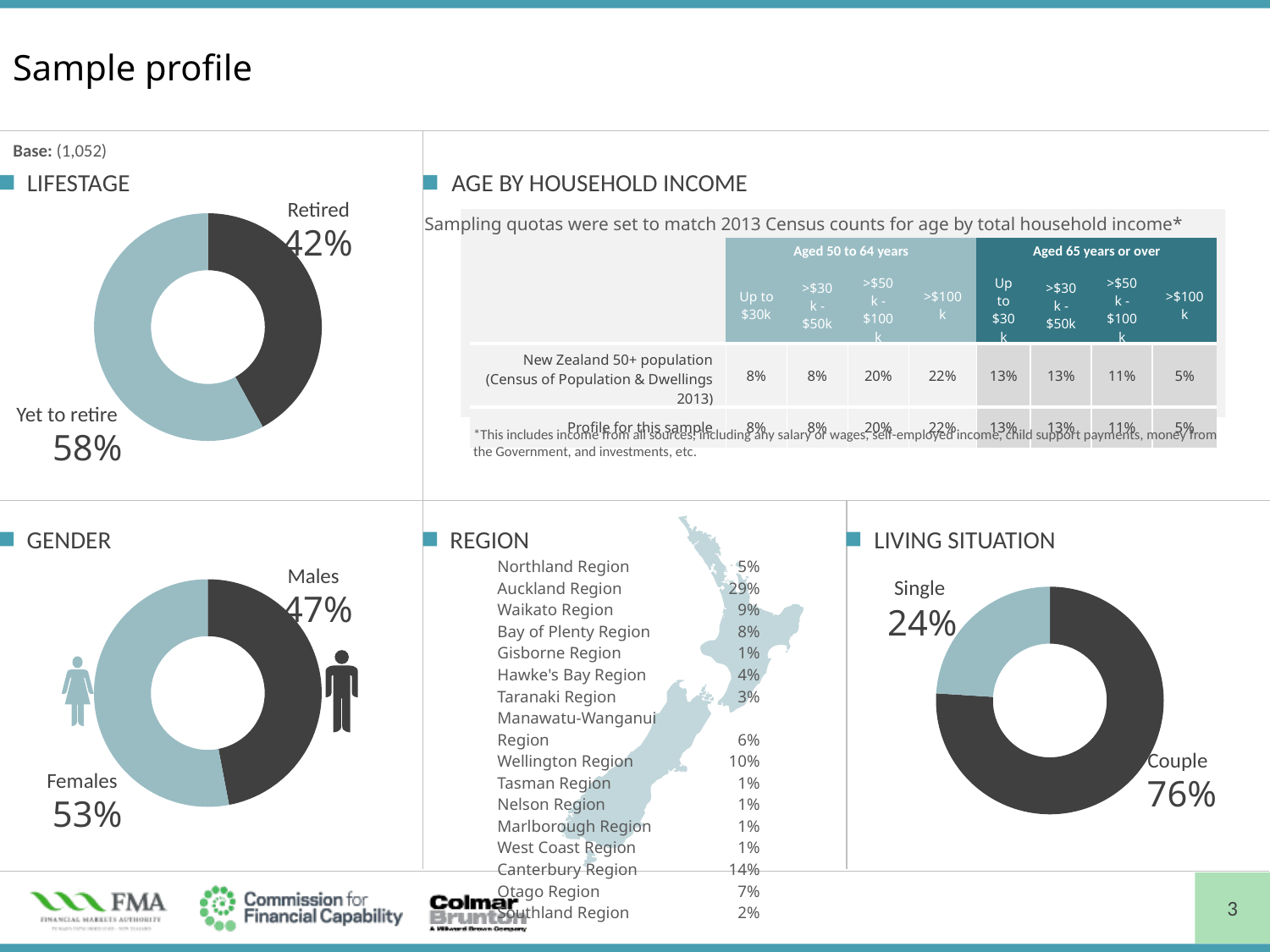
On the LIFESTAGE chart, what is the difference in percentage points between Yet to retire and Retired? 16 On the LIFESTAGE chart, what percentage of the sample is yet to retire? 58% On the LIVING SITUATION chart, what percentage of the sample is in a couple? 76% On the GENDER chart, what percentage of the sample is male? 47% On the GENDER chart, what percentage of the sample is female? 53% What kind of chart is used for LIFESTAGE? Donut (pie) chart How many categories does the GENDER chart show? 2 On the LIFESTAGE chart, what percentage of the sample is retired? 42% On the LIFESTAGE chart, which category has the larger share? Yet to retire On the GENDER chart, which group is larger, Males or Females? Females On the LIVING SITUATION chart, what percentage of the sample is single? 24% On the LIVING SITUATION chart, what is the difference in percentage points between Couple and Single? 52